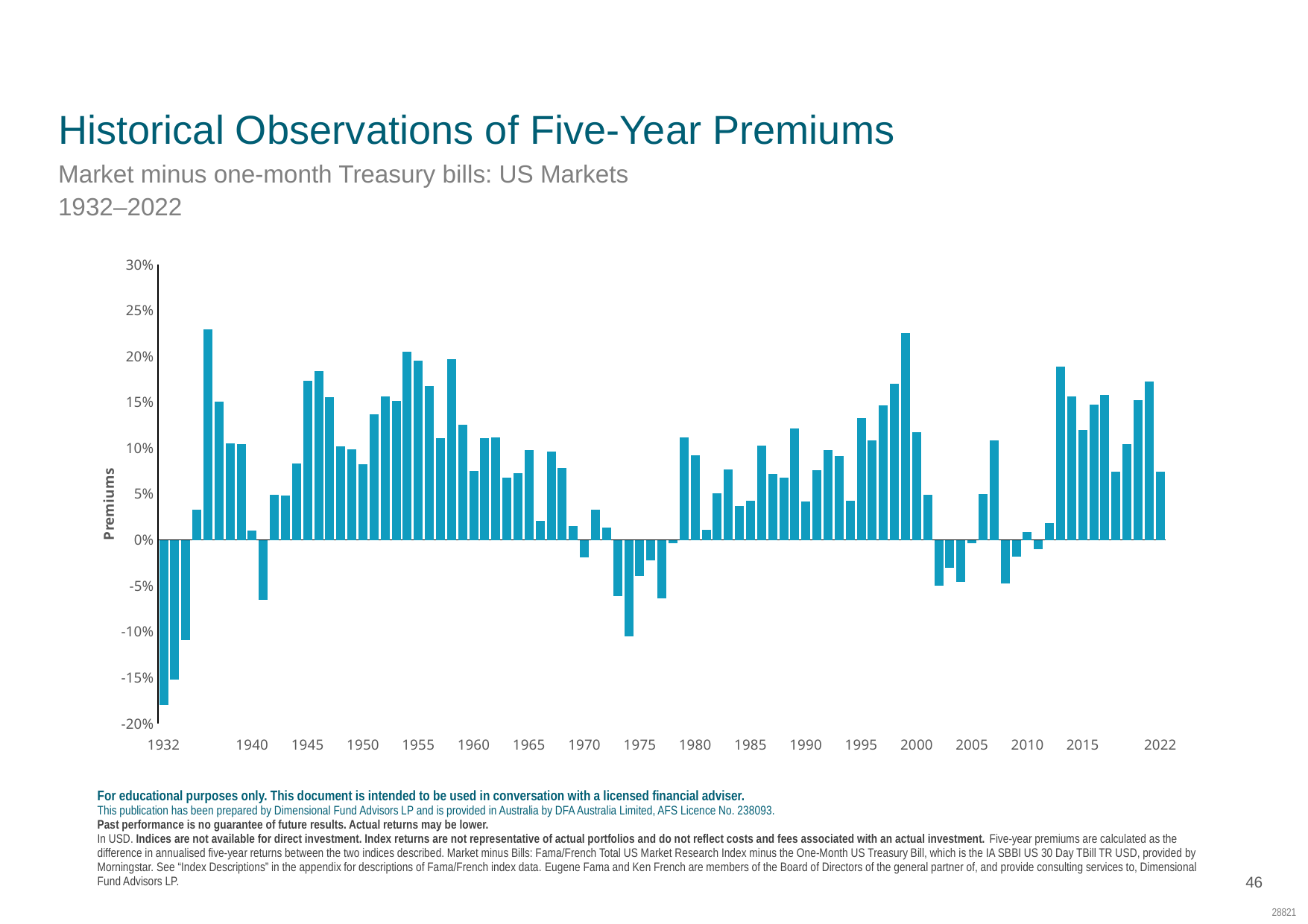
Is the value for 1995 greater or less than 10%? greater What range of years does the chart cover, according to the slide subtitle? 1932–2022 What is the label on the vertical axis of the chart? Premiums Is the value for 2022 greater or less than 5%? greater What kind of chart is shown on the slide? Bar chart Which has the larger five-year premium, 1932 or 1940? 1940 Which has the larger five-year premium, 1945 or 1950? 1945 Is the value for 1945 greater or less than 15%? greater Which year has the lowest five-year premium on the chart? 1932